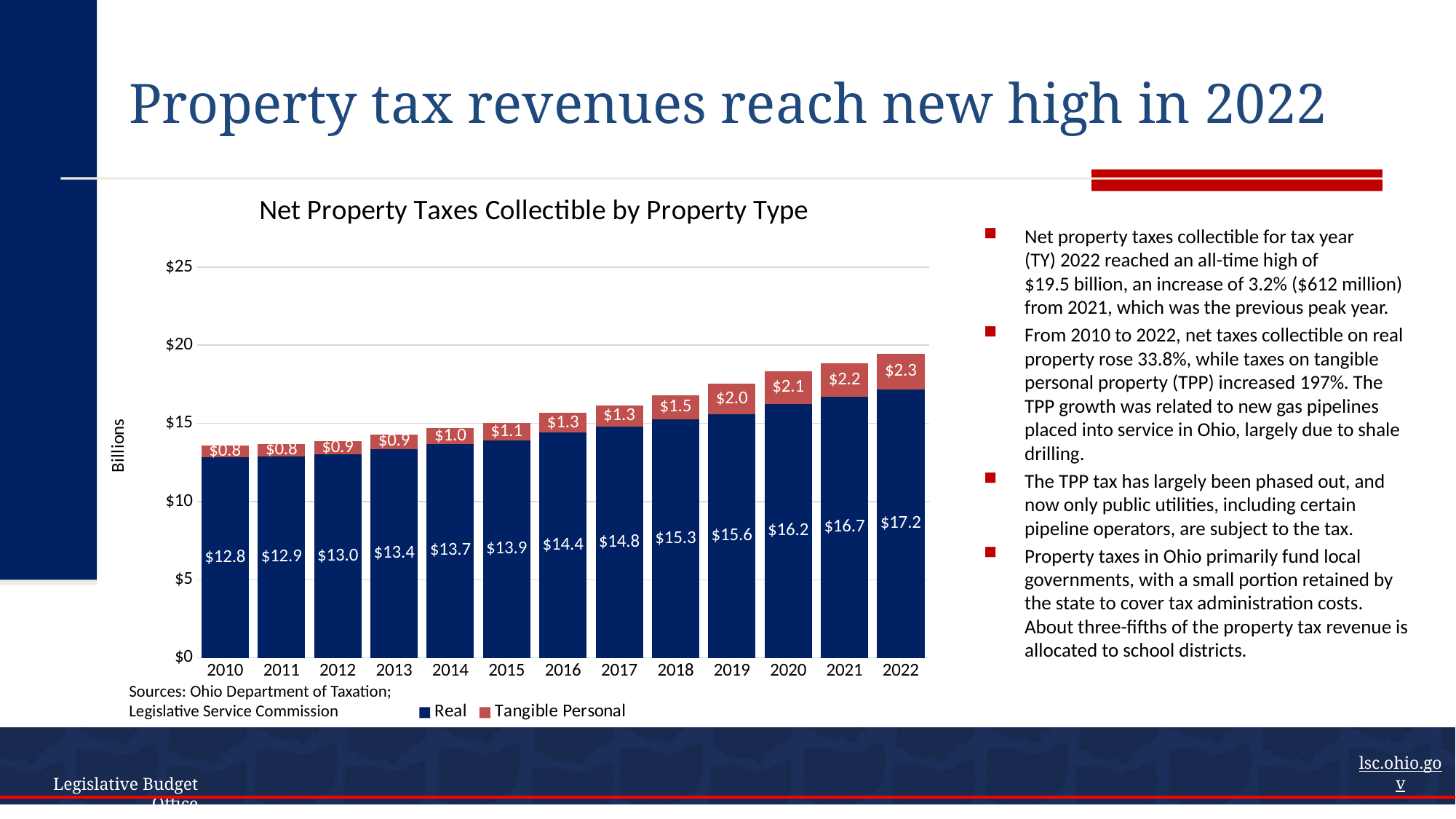
In which year is the Tangible Personal value highest? 2022 How many series does the legend list? 2 How many years are shown on the x axis? 13 What is the value for Real property in 2022? $17.2 What is the value for Real property in 2010? $12.8 Do the Real property values rise or fall from 2010 to 2022? rise Is the total stacked bar for 2010 greater or less than $15? less What is the value for Tangible Personal property in 2019? $2.0 What is the total of the stacked bar for 2022? $19.5 In which year is the Real property value highest? 2022 What is the difference between the Real property value in 2022 and in 2010? $4.4 Which is larger, the Real property value in 2018 or in 2015? 2018